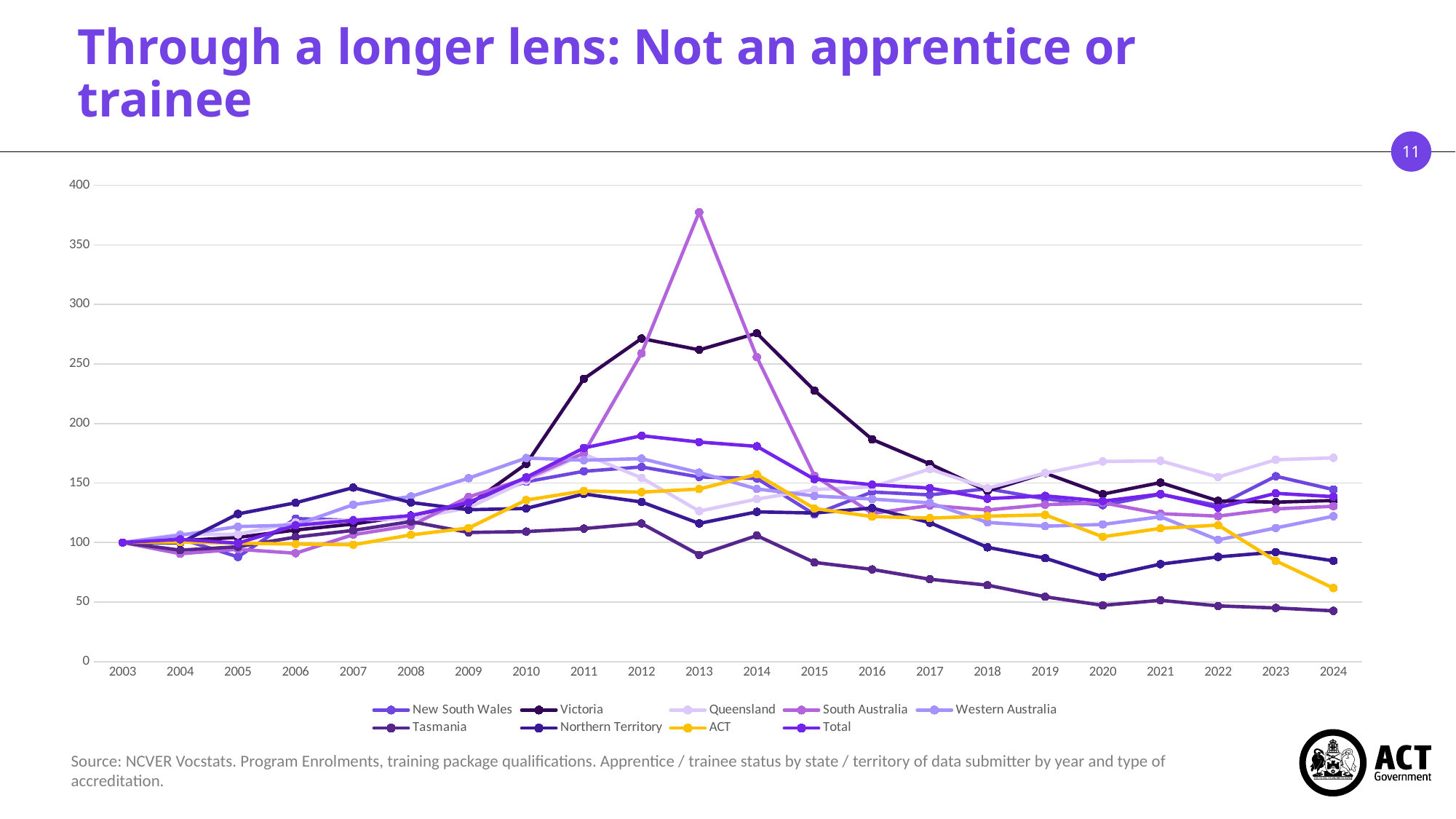
Which series reaches the highest value on the chart, in 2013? South Australia What is the title of the slide? Through a longer lens: Not an apprentice or trainee How many series does the legend list? 9 Is the value for ACT in 2024 greater or less than 100? less How many years are shown along the x axis? 22 What kind of chart is shown on the slide? line chart In 2014, which is larger: Victoria or Tasmania? Victoria Is the value for South Australia in 2013 greater or less than 350? greater Does the Tasmania line rise or fall from 2014 to 2024? fall Which series has the lowest value in 2024? Tasmania Is the value for Victoria in 2012 greater or less than 250? greater What is the value for Victoria in 2003? 100